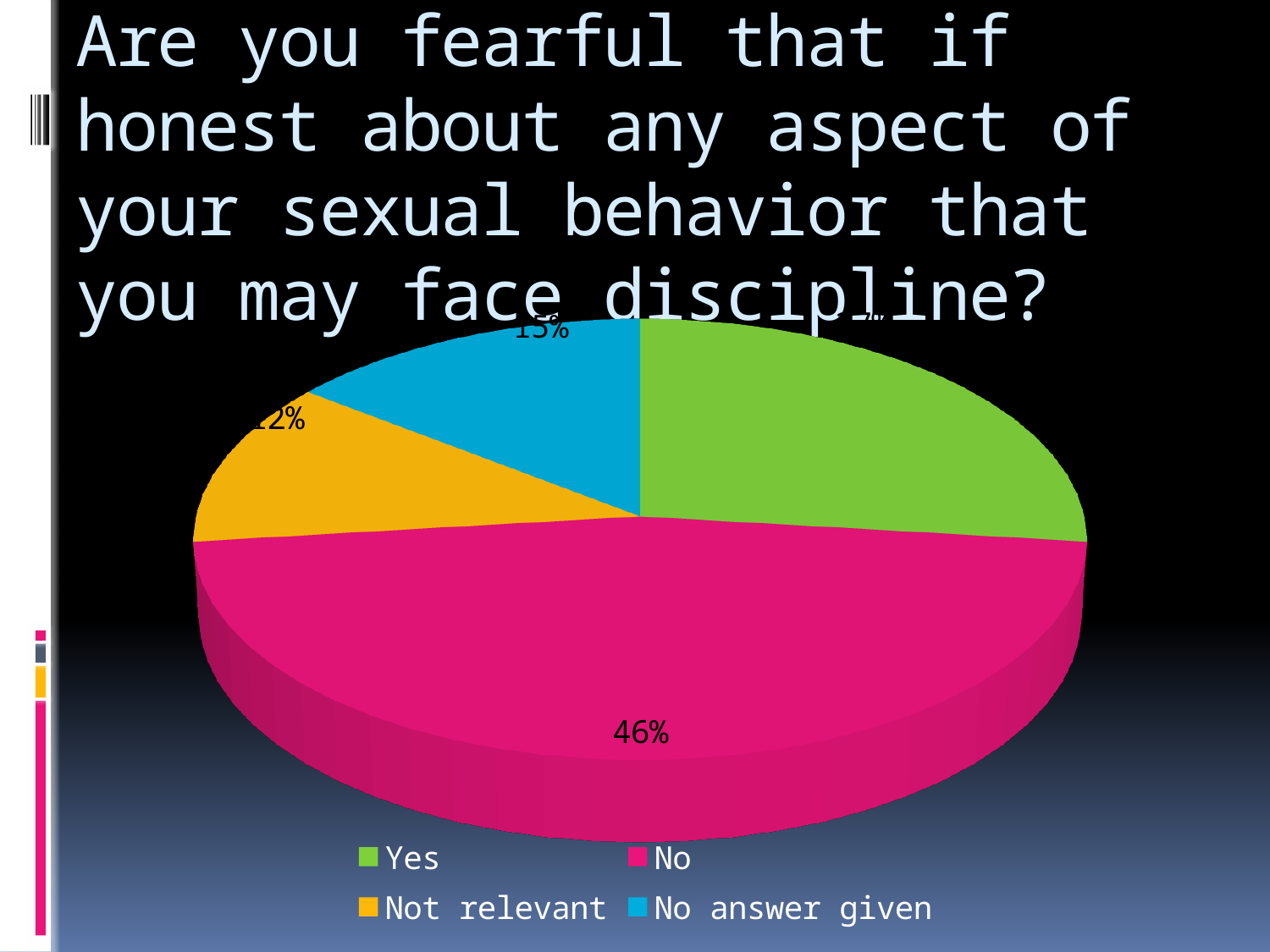
How many slices does the pie chart have? 4 What kind of chart is shown on the slide? Pie chart What percentage of the pie is the "No answer given" slice? 15% Which is larger, the "No" slice or the "Yes" slice? No What colour is the "No" slice in the pie chart? Pink Which legend entry is shown in green? Yes What share of the pie does the "No" response account for? 46% What is the difference in percentage points between the "No" slice and the "No answer given" slice? 31 What percentage of the pie is the "No" slice? 46% Which response has the largest slice of the pie? No Which is larger, the "No" slice or the "No answer given" slice? No How many entries does the legend list? 4